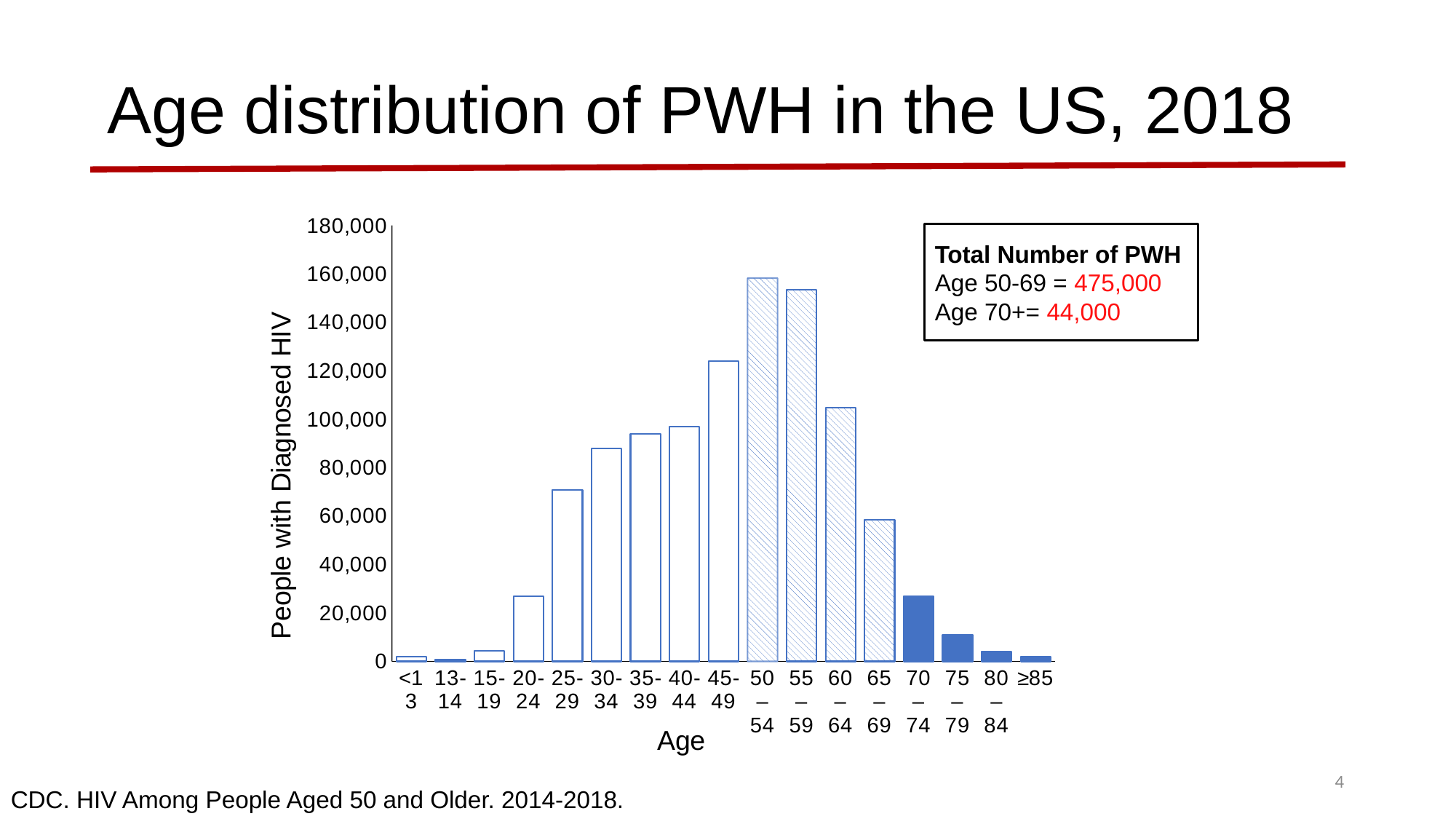
Which has more people with diagnosed HIV, the 45-49 age group or the 60-64 age group? 45–49 What kind of chart is shown on the slide? bar chart Is the value for the 35-39 age group greater or less than 100,000? less Which has more people with diagnosed HIV, the 25-29 age group or the 65-69 age group? 25–29 According to the text box on the chart, what is the total number of PWH aged 50-69? 475,000 Is the value for the 30-34 age group greater or less than 80,000? greater Is the value for the 20-24 age group greater or less than 20,000? greater Which age group has the highest number of people with diagnosed HIV? 50–54 How many age categories are shown on the x axis? 17 What is the title of the chart? Age distribution of PWH in the US, 2018 Do the values rise or fall along the x axis from the 50-54 age group to the ≥85 age group? fall